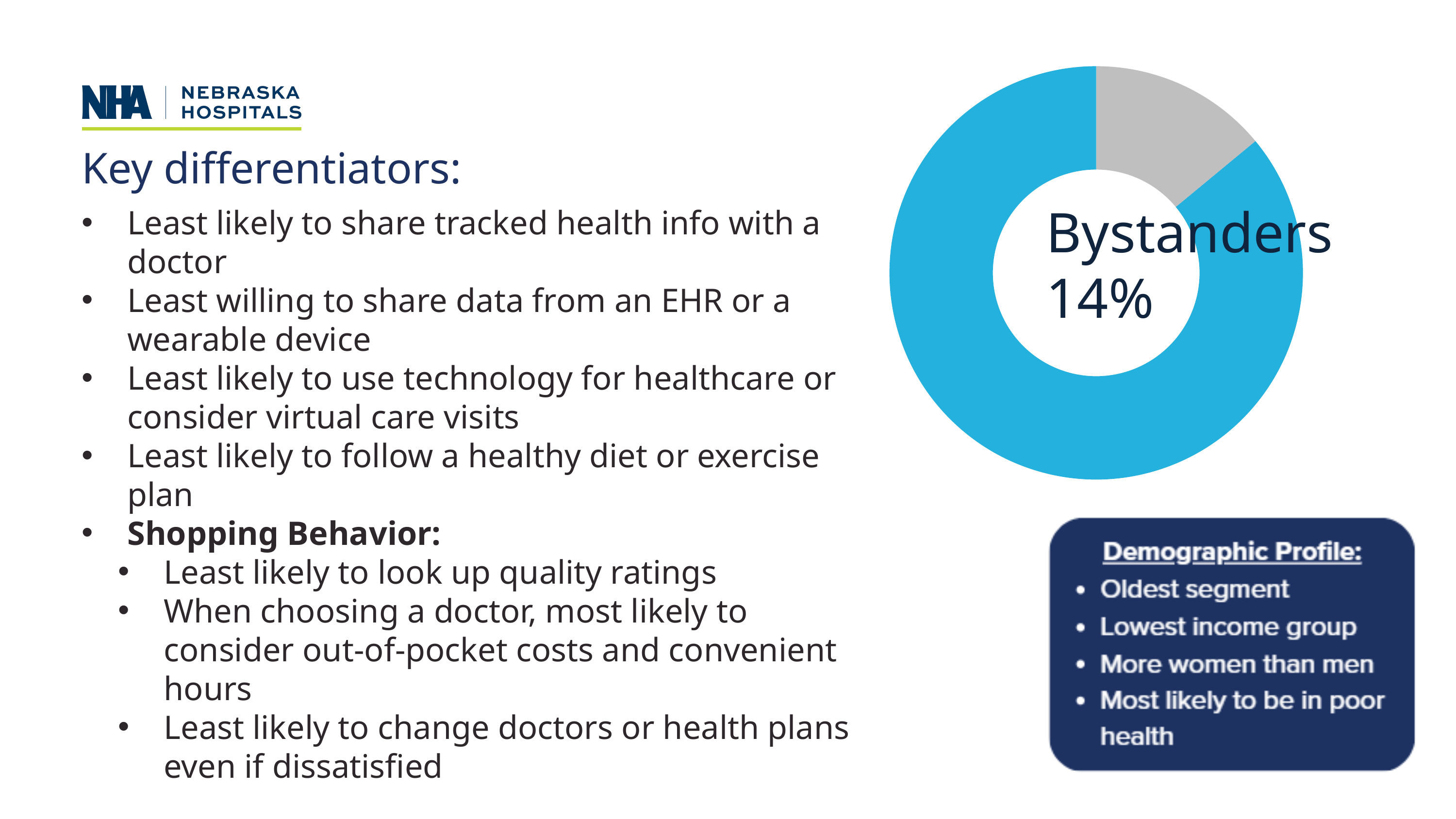
What kind of chart is shown on the right of the slide? Donut (pie) chart How many slices does the donut chart have? 2 Which slice of the donut chart is larger, the blue slice or the gray slice? The blue slice What colour is the slice representing the Bystanders segment (14%) in the donut chart? Gray What share of the donut chart does the Bystanders segment represent? 14% Which slice of the donut chart is the smallest? The gray slice (Bystanders, 14%) What percentage is shown for Bystanders in the donut chart? 14% What label is printed in the center of the donut chart? Bystanders 14%